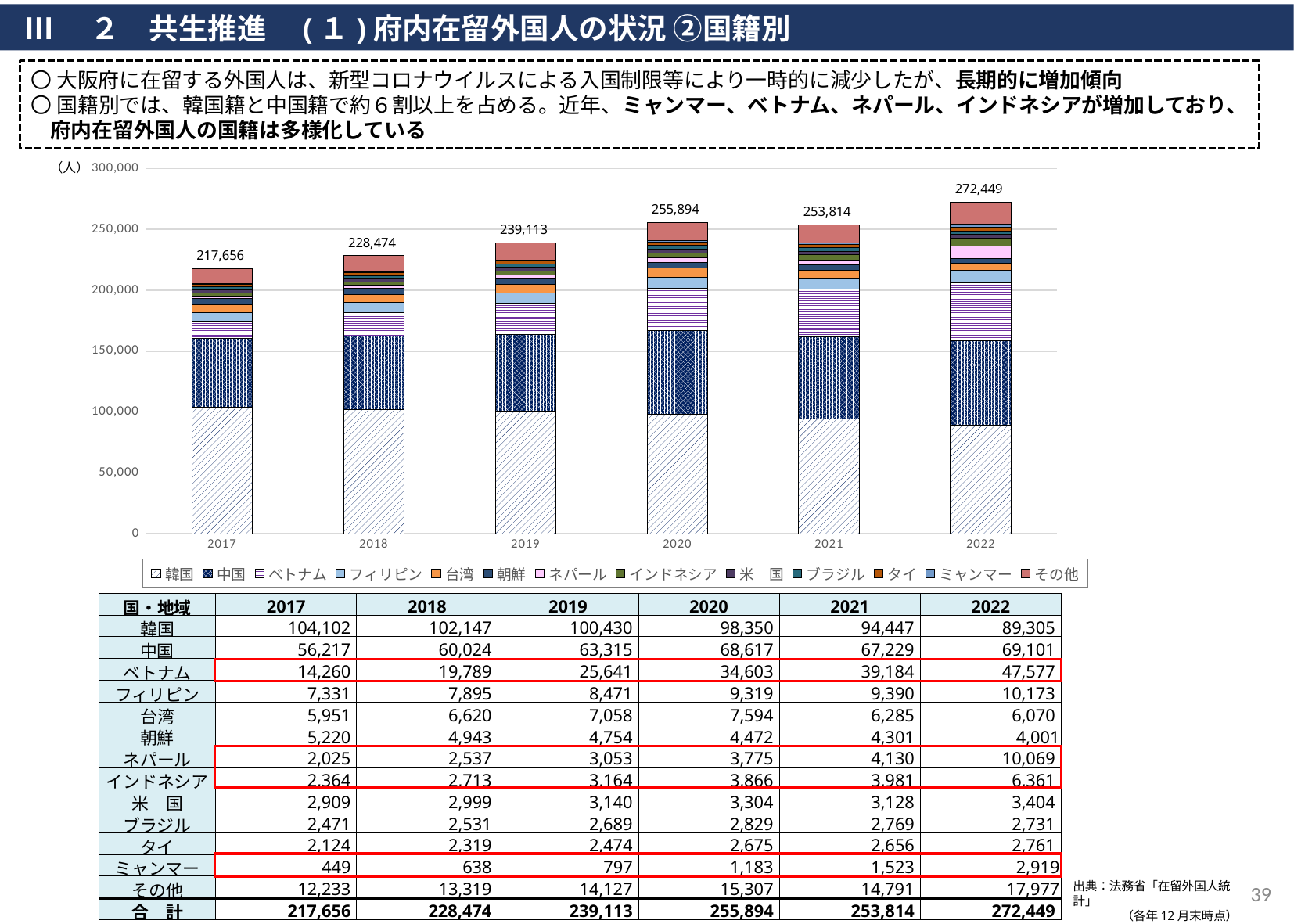
What kind of chart is shown on the slide? Stacked bar chart Is the total for 2019 greater or less than 250,000? less Which year has the highest total in the chart? 2022 What is the total number of foreign residents shown for 2017? 217,656 According to the table, what is the value for ベトナム in 2022? 47,577 How many years are shown on the x axis of the chart? 6 Do the totals rise or fall from 2017 to 2020? Rise Which year has the larger total, 2020 or 2021? 2020 What is the difference between the 2022 total and the 2021 total? 18,635 How many series does the chart legend list? 13 What is the total number of foreign residents shown for 2022? 272,449 Which year has the lowest total in the chart? 2017